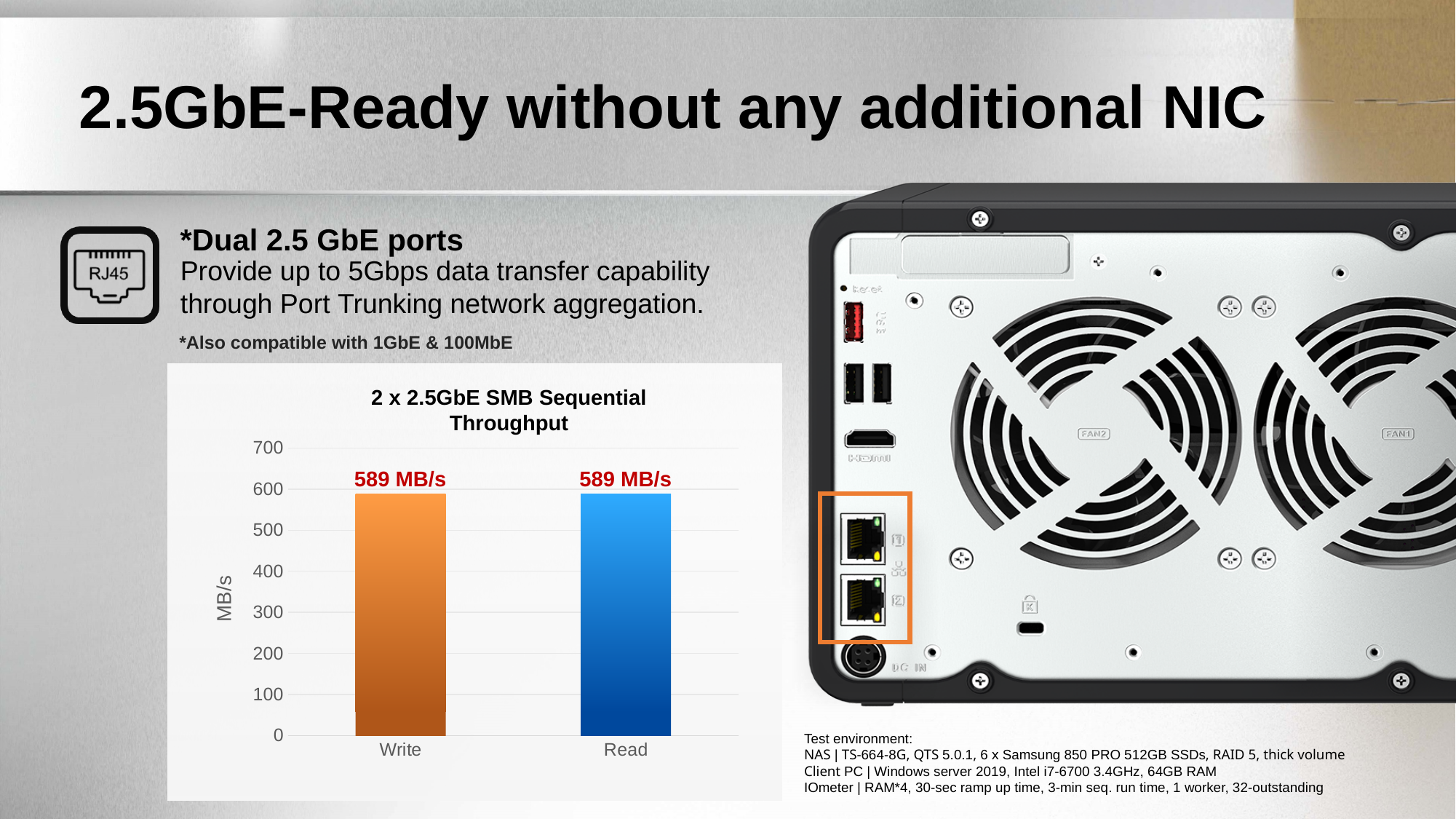
What is the value for Read in the chart? 589 MB/s What kind of chart is shown on the slide? bar chart Is the value for Write greater or less than 500? greater How many categories are shown on the x axis of the chart? 2 What is the label on the y axis of the chart? MB/s What is the title of the chart? 2 x 2.5GbE SMB Sequential Throughput What is the highest tick value shown on the y axis of the chart? 700 What is the difference between the Write and Read values in the chart? 0 MB/s Is the value for Read greater or less than 600? less What is the value for Write in the chart? 589 MB/s